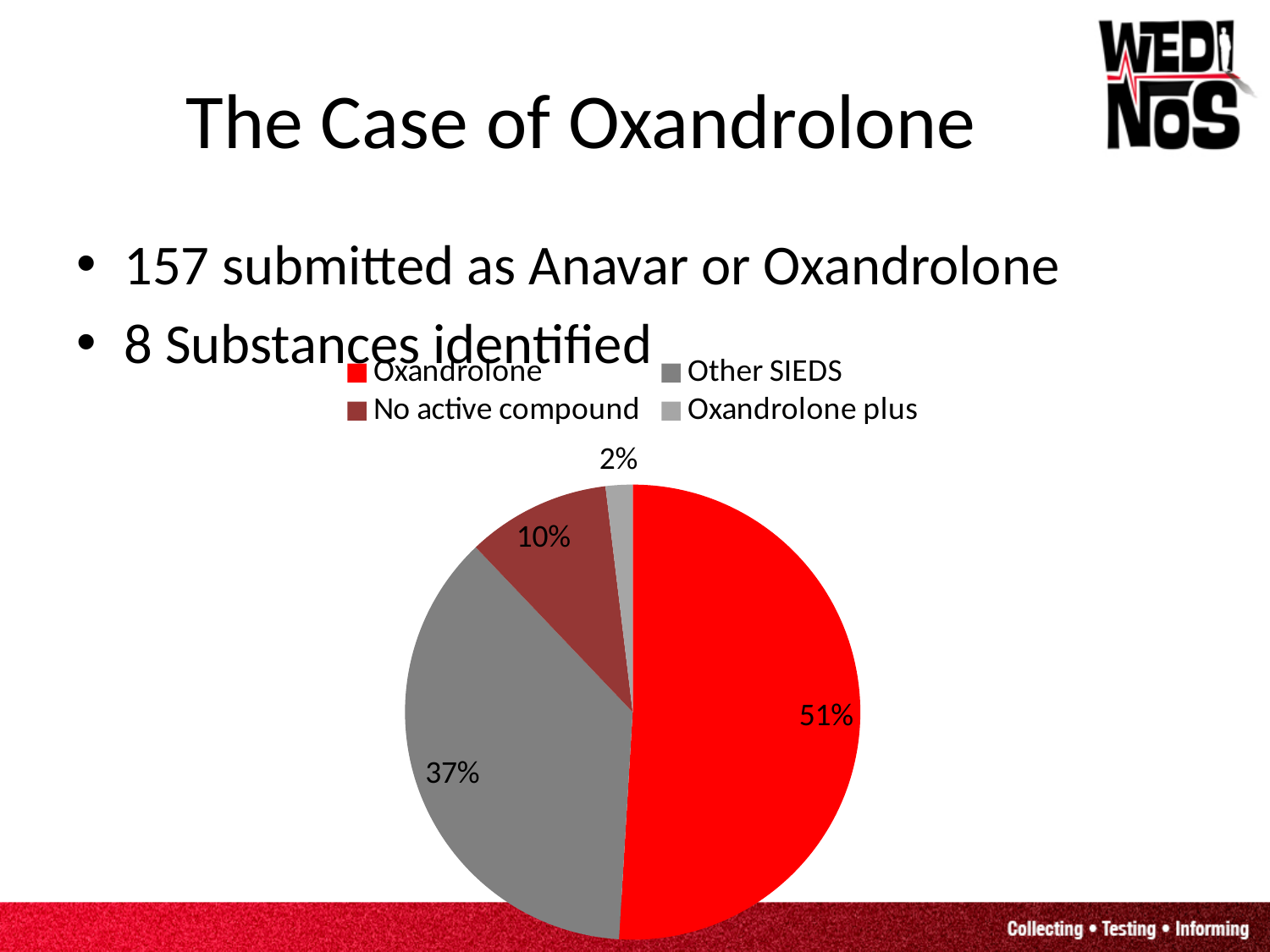
What share of the pie does Oxandrolone plus account for? 2% Which category has the largest slice of the pie? Oxandrolone How many categories does the pie chart show? 4 What colour is the Other SIEDS slice? grey What is the difference in percentage points between the Oxandrolone slice and the Other SIEDS slice? 14 What share of the pie does No active compound account for? 10% What share of the pie does Other SIEDS account for? 37% Which is larger, the No active compound slice or the Oxandrolone plus slice? No active compound What kind of chart is shown on the slide? pie chart How many entries does the legend list? 4 Which category has the smallest slice of the pie? Oxandrolone plus